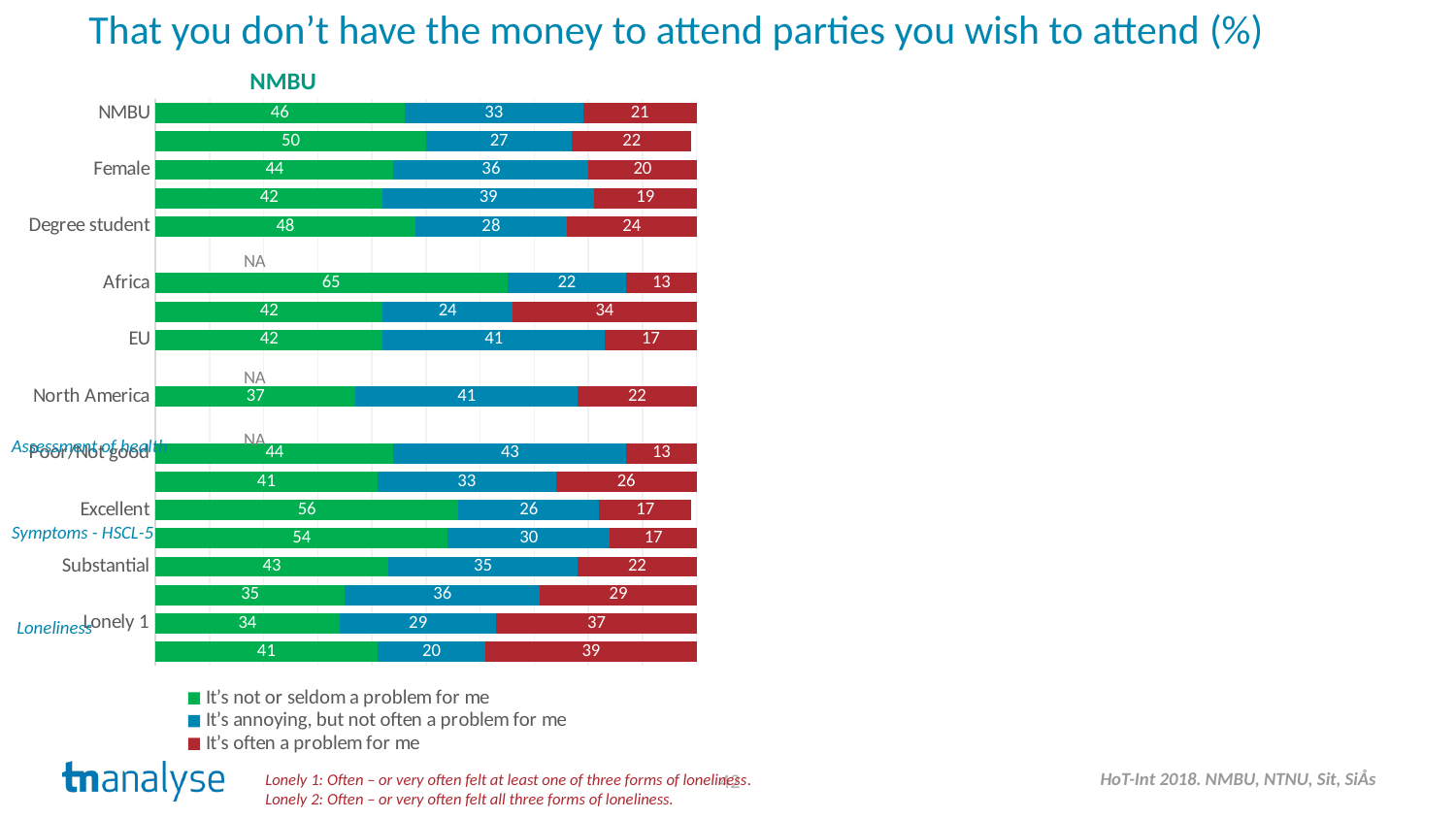
What is the total of the stacked bar for North America? 100 Which is larger: the "It's not or seldom a problem for me" value for Degree student or for Female? Degree student What is the difference between the "It's often a problem for me" values for Lonely 1 and Africa? 24 What kind of chart is shown on the slide? Stacked bar chart How many series does the legend list? 3 What is the value of "It's annoying, but not often a problem for me" for EU? 41 What is the value of "It's often a problem for me" for Lonely 1? 37 What is the value of "It's often a problem for me" for Poor/Not good? 13 What is the value of "It's not or seldom a problem for me" for Excellent? 56 What is the value of "It's not or seldom a problem for me" for Africa? 65 Which labelled category has the highest value for "It's not or seldom a problem for me"? Africa